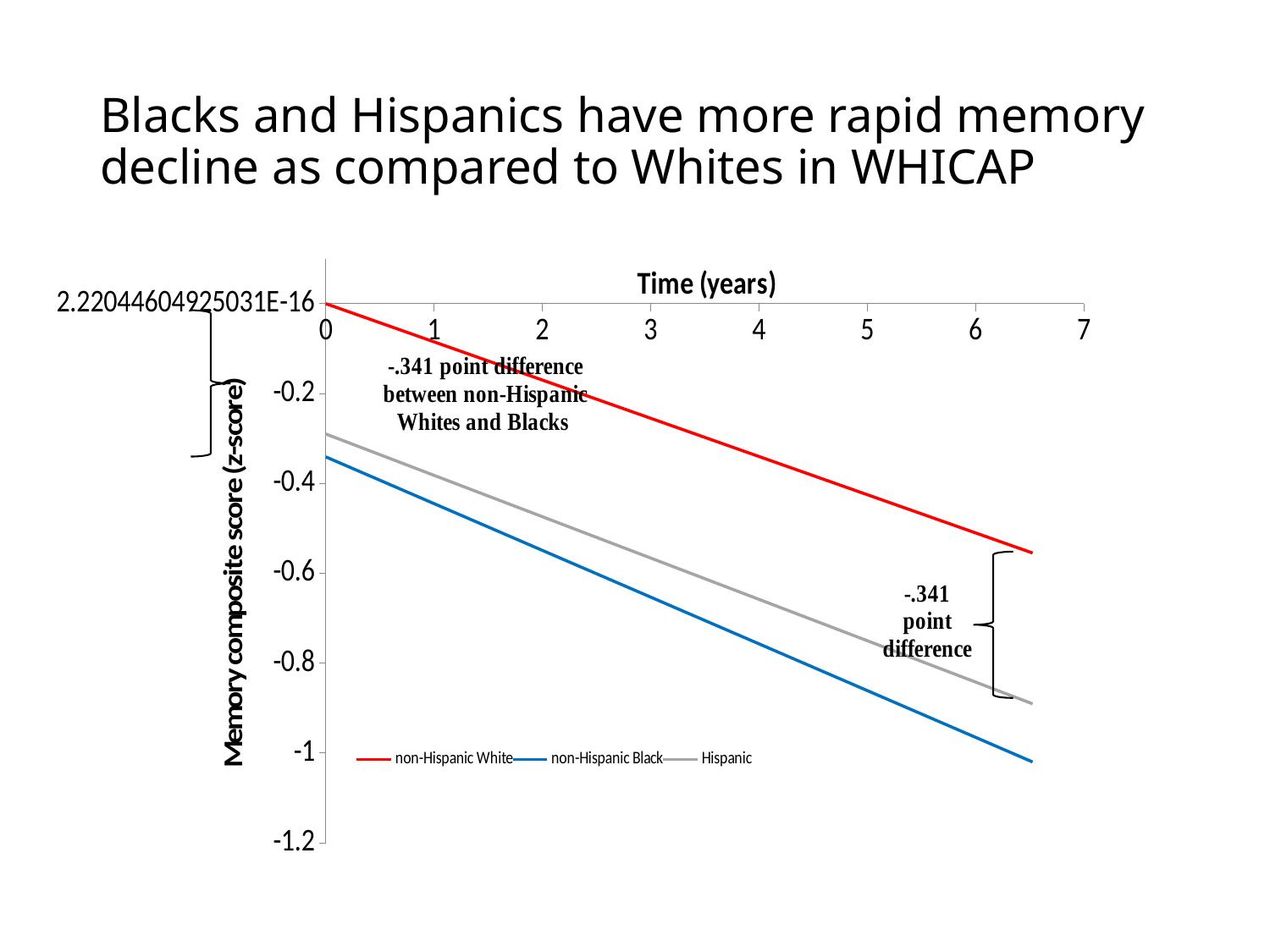
At time 0, is the memory composite score for Hispanic greater or less than -0.4? greater What is the label of the x axis? Time (years) Which series has the highest memory composite score across the time range? non-Hispanic White How many series does the legend list? 3 Which series has a higher memory composite score at time 3, Hispanic or non-Hispanic Black? Hispanic At time 0, is the memory composite score for non-Hispanic Black greater or less than -0.2? less Which series has the lowest memory composite score across the time range? non-Hispanic Black What kind of chart is shown on the slide? line chart What point difference between non-Hispanic Whites and Blacks is annotated on the chart? -.341 At the end of the plotted period, is the memory composite score for non-Hispanic White greater or less than -0.4? less Do the memory composite scores rise or fall as time increases? fall